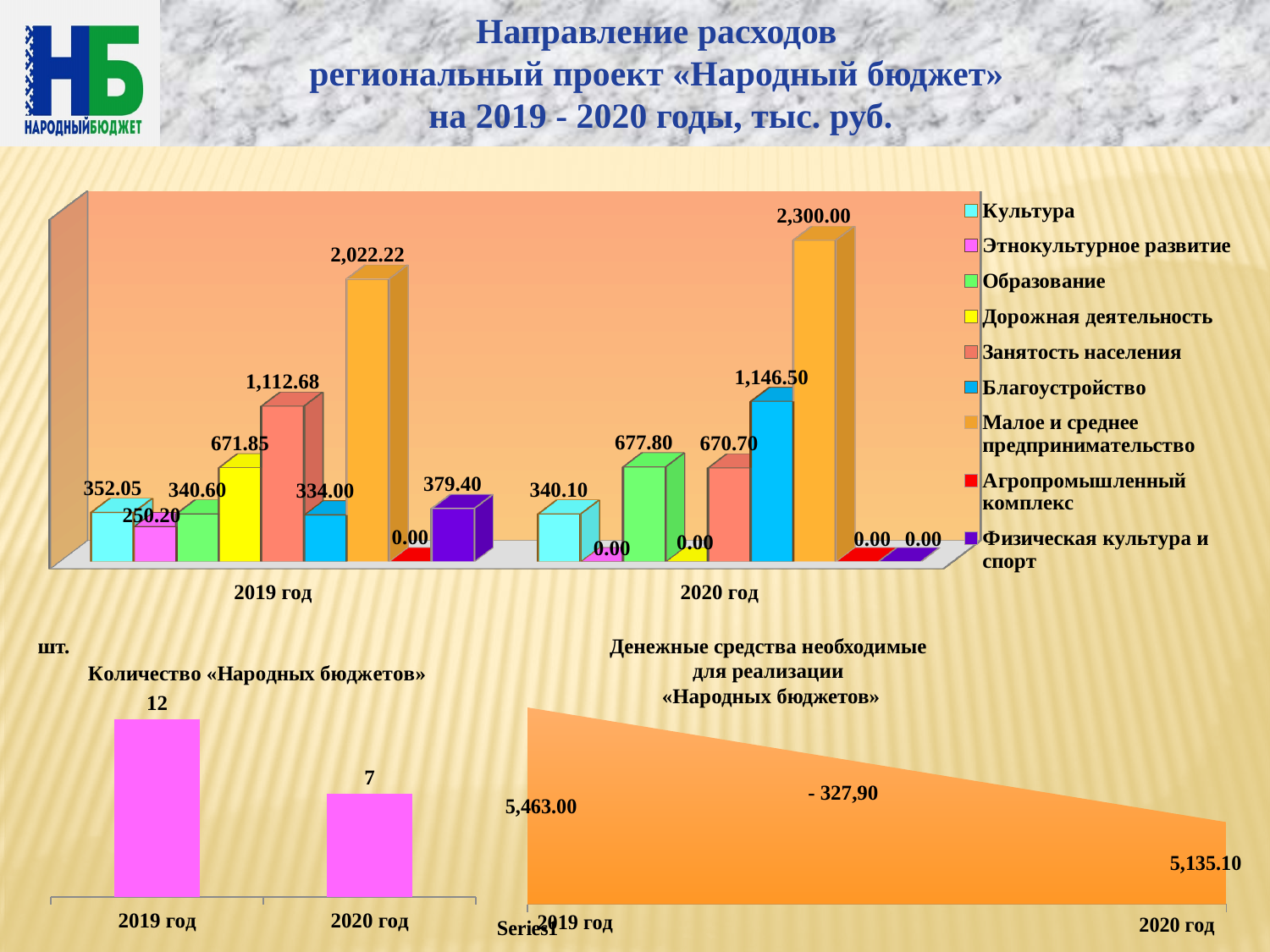
In the top chart, what is the value for Малое и среднее предпринимательство in 2020 год? 2,300.00 In the top chart, what is the value for Благоустройство in 2020 год? 1,146.50 In the chart titled Количество «Народных бюджетов», what is the value for 2020 год? 7 In the bottom-right chart, what is the value for 2019 год? 5,463.00 In the top chart, which is larger: Образование in 2019 год or Образование in 2020 год? Образование in 2020 год What kind of chart is the bottom-right chart titled Денежные средства необходимые для реализации «Народных бюджетов»? Area chart In the top chart, which colour represents Дорожная деятельность? Yellow In the chart titled Количество «Народных бюджетов», what is the difference between 2019 год and 2020 год? 5 In the top chart, what is the value for Занятость населения in 2019 год? 1,112.68 In the top chart, which series has the highest value in 2019 год? Малое и среднее предпринимательство In the top chart, what is the difference between the Малое и среднее предпринимательство values for 2020 год and 2019 год? 277.78 How many series does the legend of the top chart list? 9